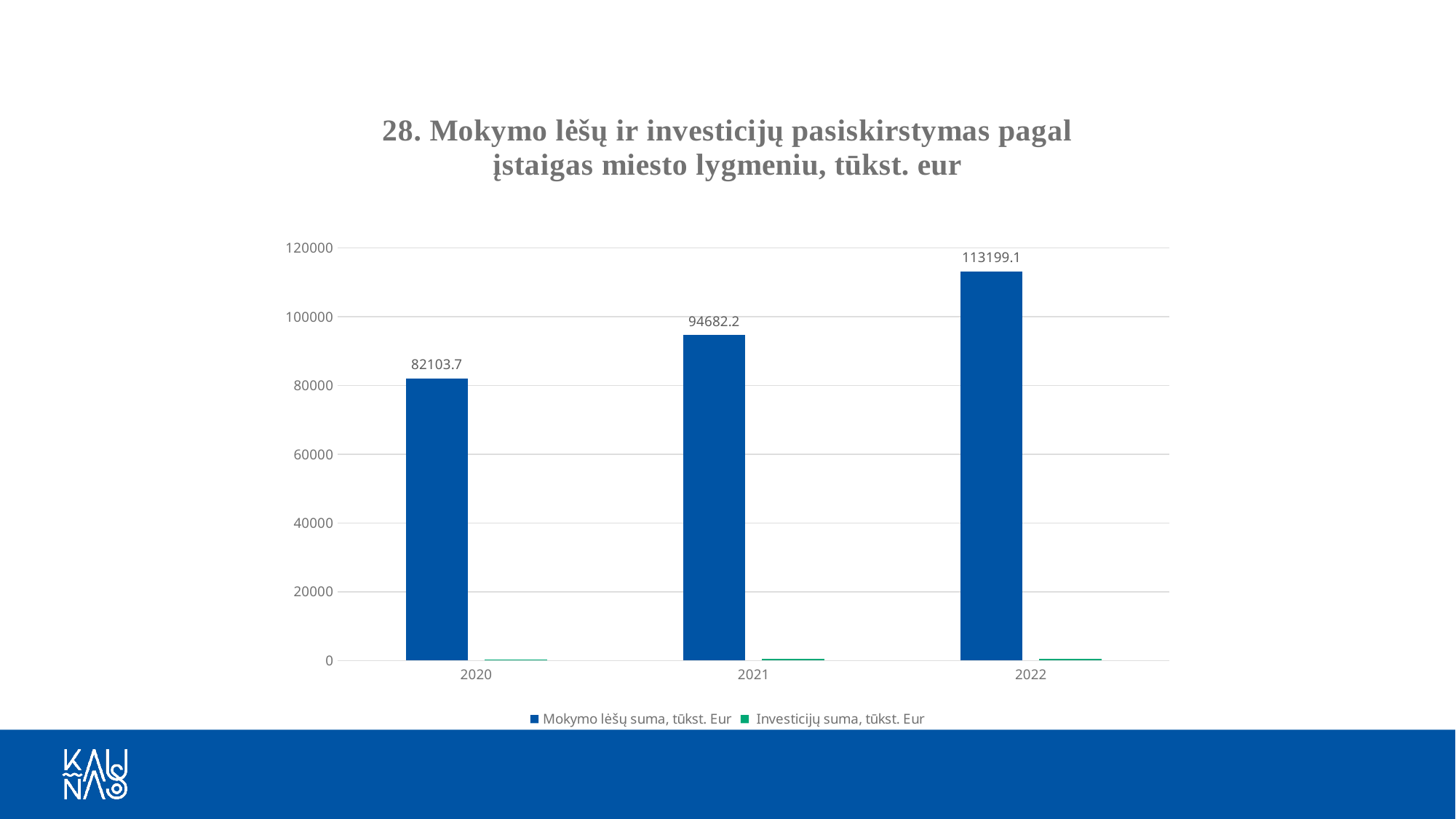
Which is larger in 2021: Mokymo lėšų suma, tūkst. Eur or Investicijų suma, tūkst. Eur? Mokymo lėšų suma, tūkst. Eur What is the value of Mokymo lėšų suma, tūkst. Eur for 2021? 94682.2 What is the value of Mokymo lėšų suma, tūkst. Eur for 2022? 113199.1 What is the value of Mokymo lėšų suma, tūkst. Eur for 2020? 82103.7 Is the value of Investicijų suma, tūkst. Eur for 2022 greater or less than 20000? less Does Mokymo lėšų suma, tūkst. Eur rise or fall from 2020 to 2022? rise What is the difference in Mokymo lėšų suma, tūkst. Eur between 2022 and 2021? 18516.9 What is the difference in Mokymo lėšų suma, tūkst. Eur between 2021 and 2020? 12578.5 In which year is Mokymo lėšų suma, tūkst. Eur the lowest? 2020 How many series does the legend list? 2 How many years are shown on the x axis? 3 In which year is Mokymo lėšų suma, tūkst. Eur the highest? 2022